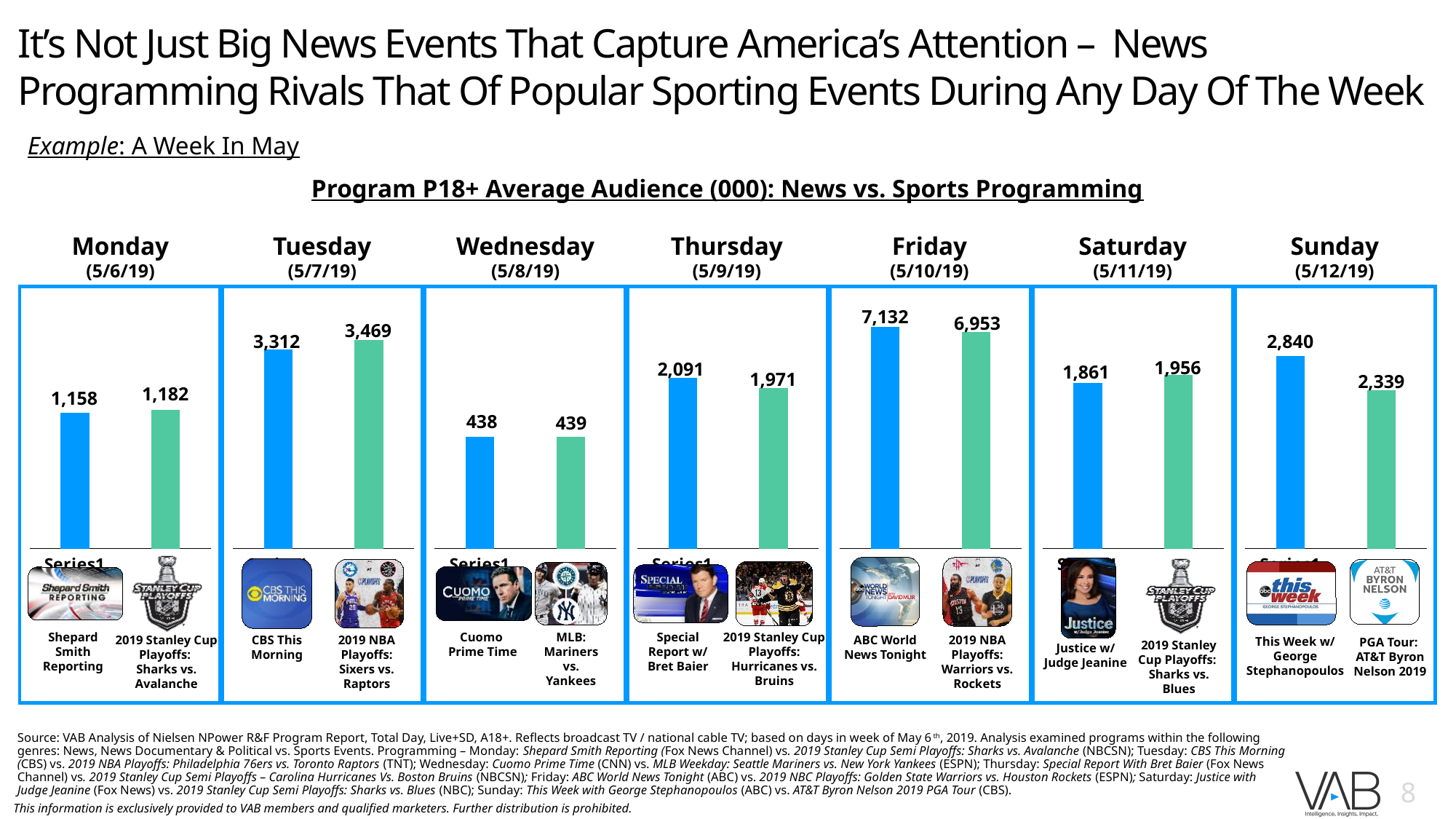
What colour are the bars for the sports programs on these charts? Green On the Friday (5/10/19) chart, what is the difference between ABC World News Tonight and the 2019 NBA Playoffs: Warriors vs. Rockets? 179 On the Sunday (5/12/19) chart, what is the difference between the two bars? 501 On the Thursday (5/9/19) chart, which program has the lower value? 2019 Stanley Cup Playoffs: Hurricanes vs. Bruins On the Friday (5/10/19) chart, what is the P18+ average audience (000) for ABC World News Tonight? 7,132 On the Tuesday (5/7/19) chart, what is the value for CBS This Morning? 3,312 How many bars does the Monday (5/6/19) chart show? 2 On the Tuesday (5/7/19) chart, how much higher is the 2019 NBA Playoffs: Sixers vs. Raptors value than CBS This Morning? 157 On the Saturday (5/11/19) chart, what is the value for the 2019 Stanley Cup Playoffs: Sharks vs. Blues? 1,956 What type of chart is used for each day on this slide? Bar chart On the Sunday (5/12/19) chart, which program has the higher value, This Week w/ George Stephanopoulos or PGA Tour: AT&T Byron Nelson 2019? This Week w/ George Stephanopoulos On the Wednesday (5/8/19) chart, what is the value for Cuomo Prime Time? 438